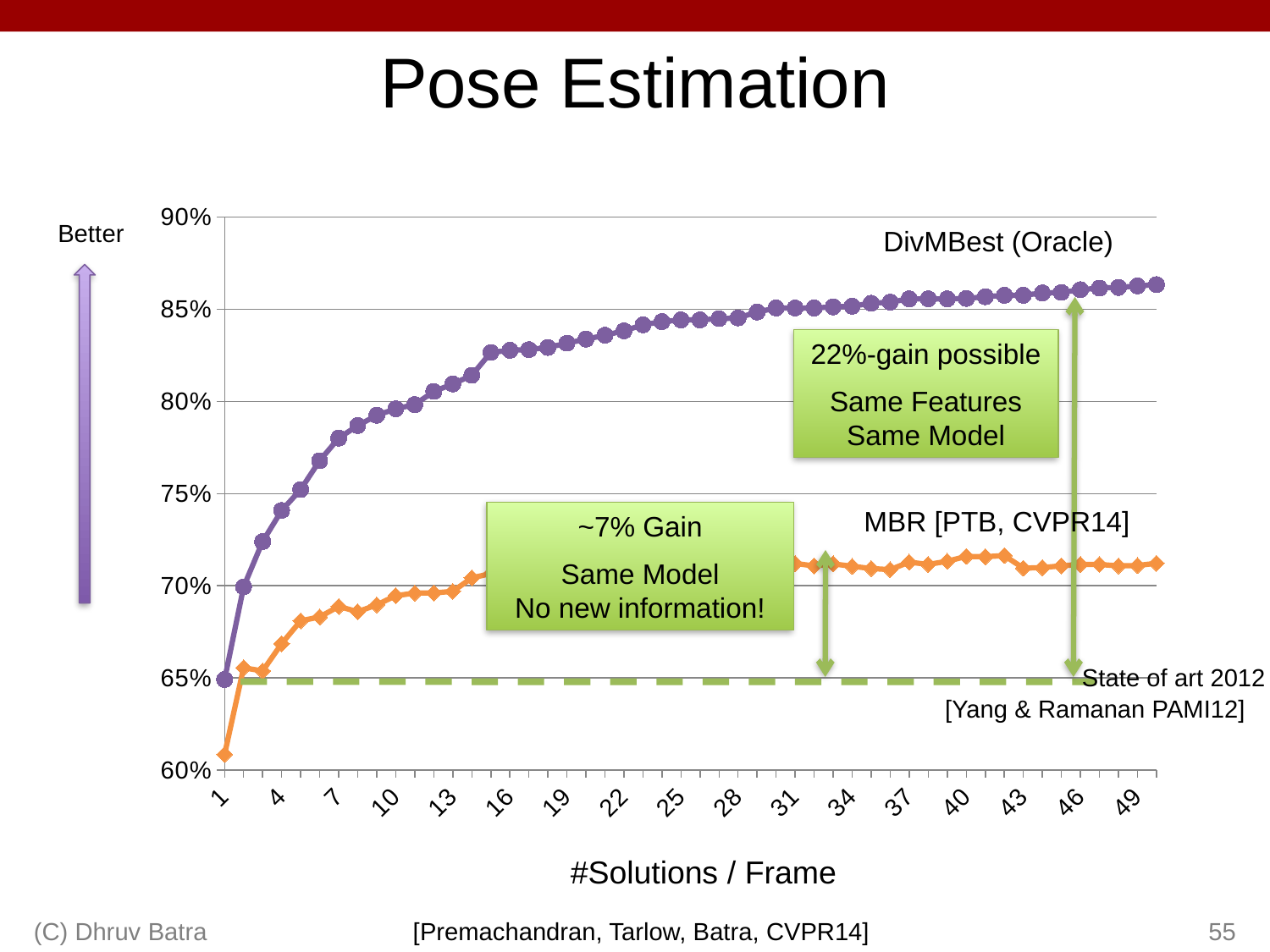
Is the value for DivMBest (Oracle) at 49 solutions per frame greater or less than 85%? greater What kind of chart is shown on the slide? line chart At 49 solutions per frame, which series has the larger value, DivMBest (Oracle) or MBR [PTB, CVPR14]? DivMBest (Oracle) Is the value for MBR [PTB, CVPR14] at 1 solution per frame greater or less than 65%? less Does the DivMBest (Oracle) series rise or fall as #Solutions / Frame increases? rise What is the x-axis title of the chart? #Solutions / Frame Is the value for DivMBest (Oracle) at 10 solutions per frame greater or less than 75%? greater Which series reaches the highest value on the chart? DivMBest (Oracle) What does the dashed green horizontal line on the chart represent? State of art 2012 [Yang & Ramanan PAMI12]